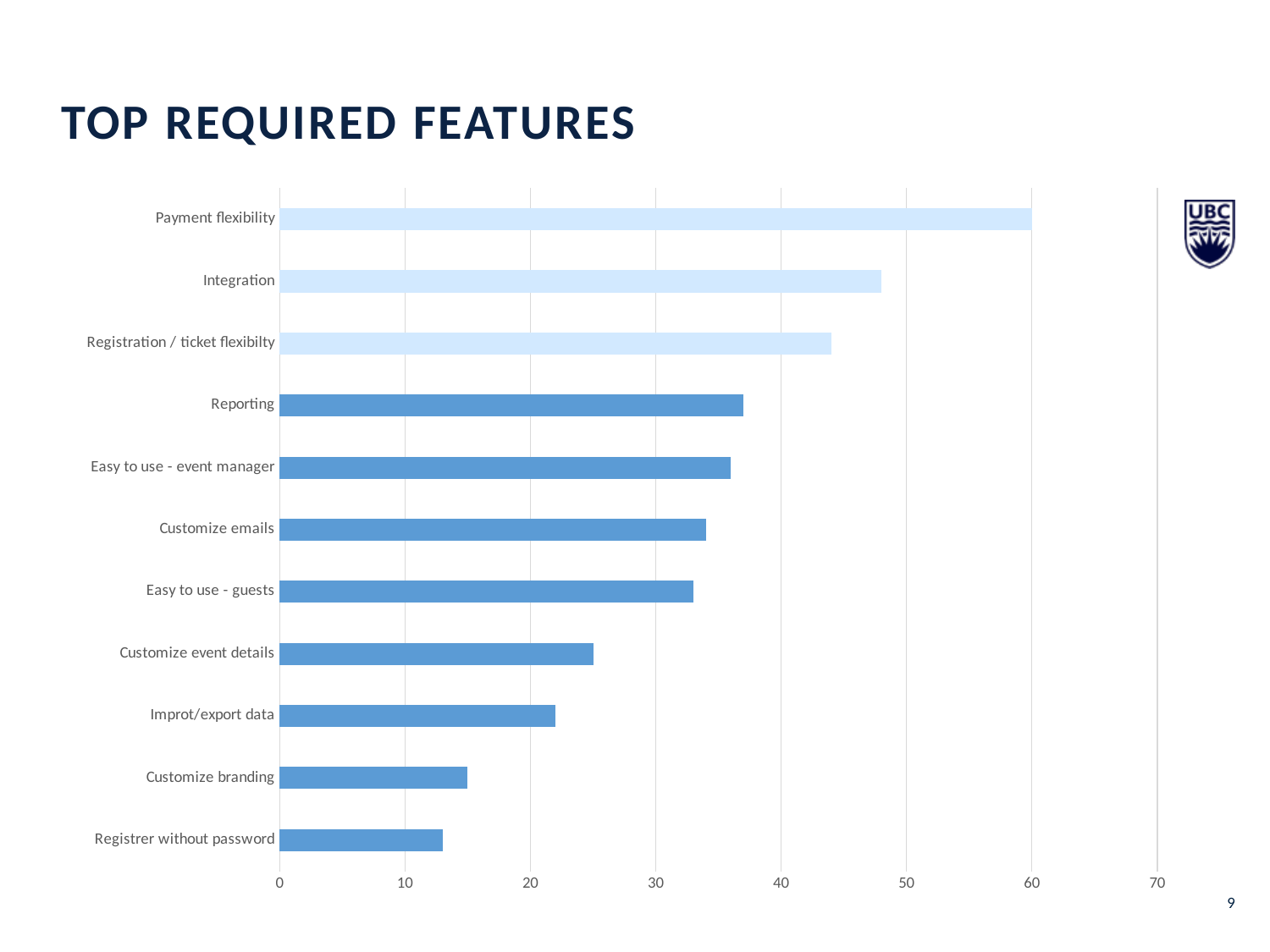
How many features are listed in the chart? 11 Is the value for Customize branding greater or less than 10? greater Which feature has the highest value in the chart? Payment flexibility Is the value for Customize event details greater or less than 30? less What is the value for Payment flexibility? 60 What is the title of the slide containing the chart? TOP REQUIRED FEATURES Which has a larger value, Customize emails or Customize branding? Customize emails Is the value for Integration greater or less than 40? greater Which has a larger value, Integration or Reporting? Integration What kind of chart is shown on the slide? bar chart Which feature has the lowest value in the chart? Registrer without password